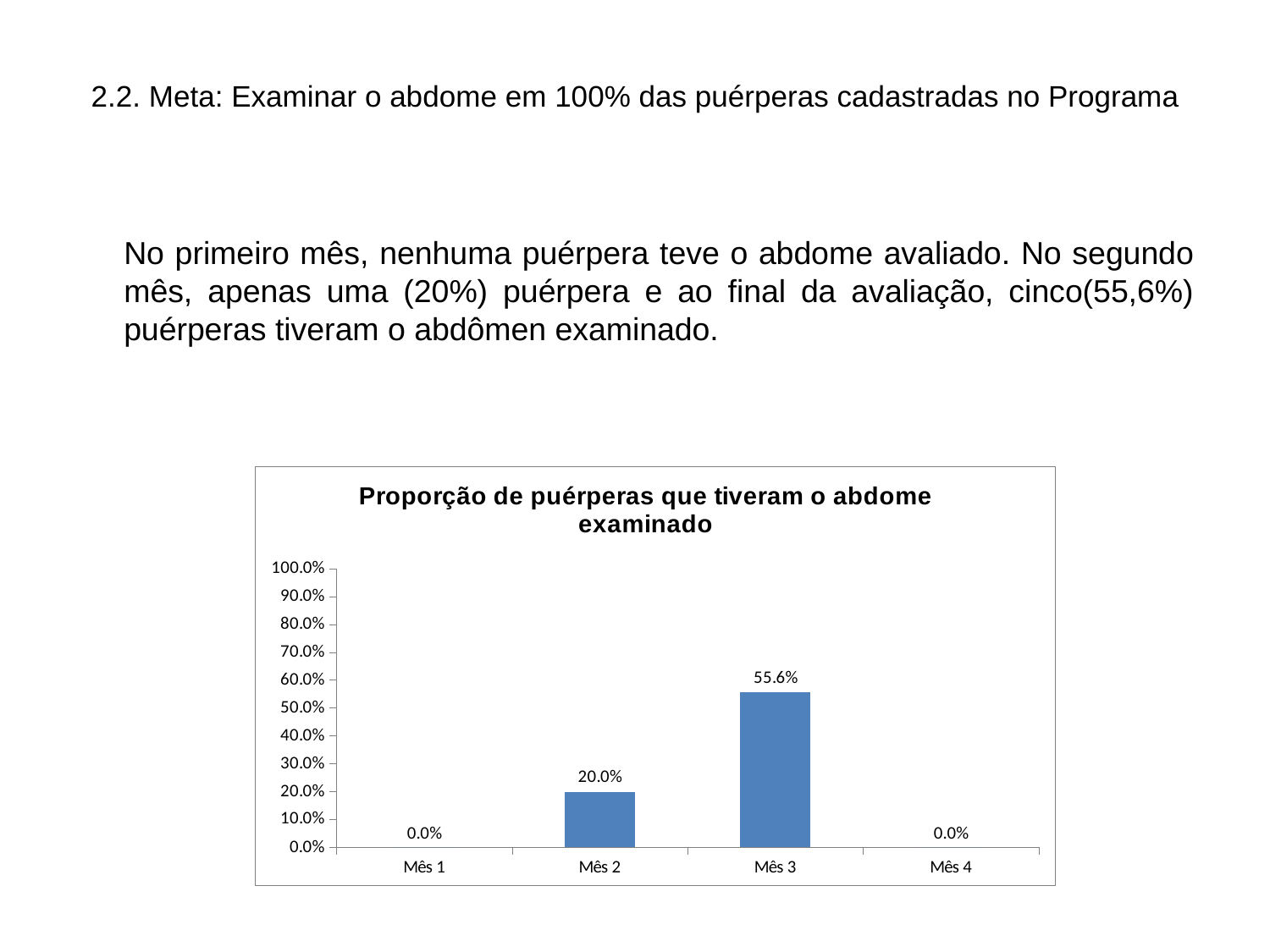
Which month has the highest value? Mês 3 What is the highest value shown on the y axis? 100.0% What is the title of the chart? Proporção de puérperas que tiveram o abdome examinado What is the value for Mês 4? 0.0% What is the value for Mês 3? 55.6% Is the value for Mês 3 greater or less than 50.0%? greater How many categories are shown on the x axis? 4 What is the value for Mês 1? 0.0% What is the difference between the values for Mês 3 and Mês 2? 35.6% What kind of chart is shown on the slide? bar chart What is the value for Mês 2? 20.0% Which is larger, the value for Mês 2 or the value for Mês 3? Mês 3